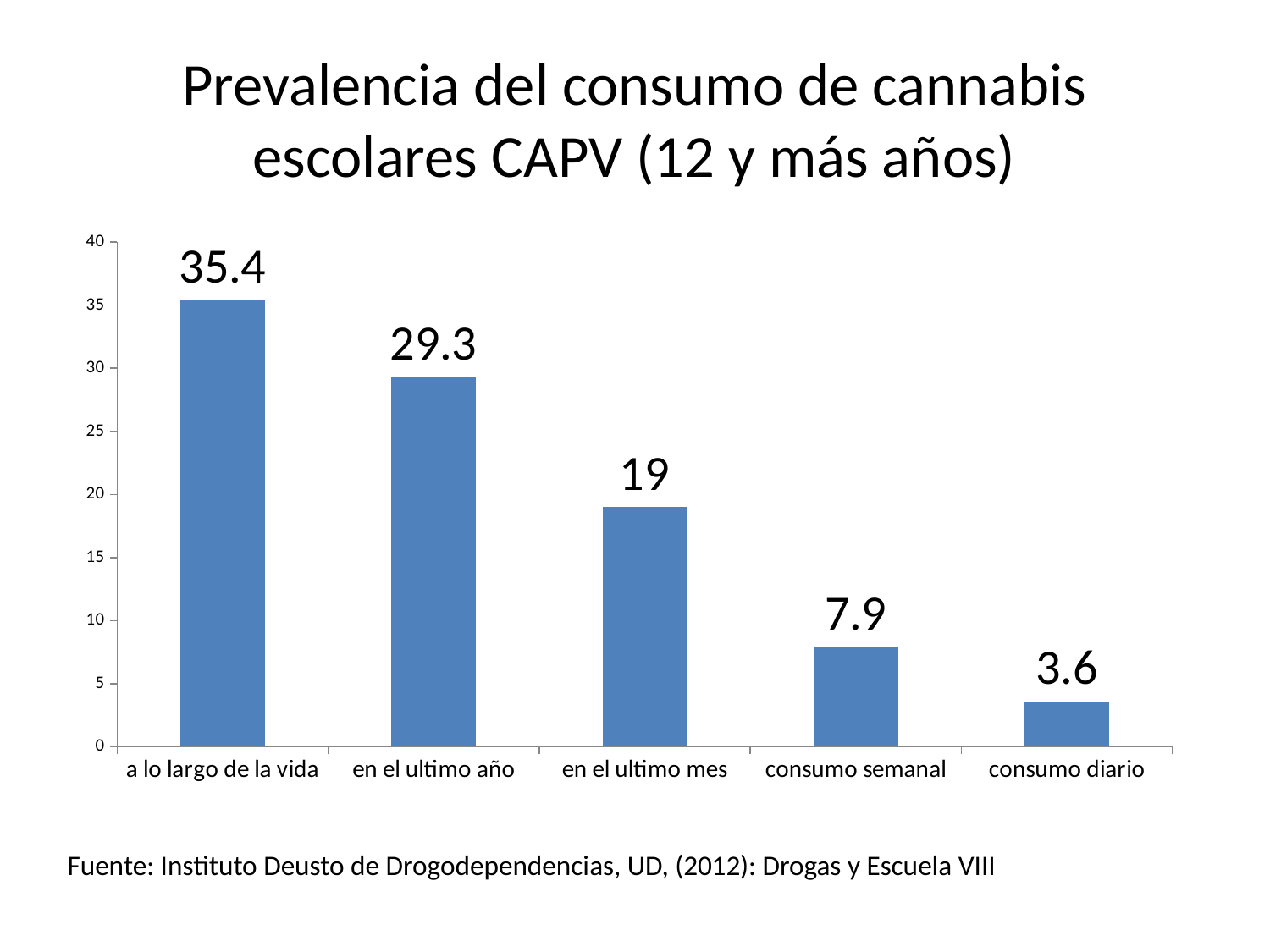
What kind of chart is shown on the slide? bar chart What is the value for 'en el ultimo mes'? 19 What is the value for 'a lo largo de la vida'? 35.4 Which category has the lowest value? consumo diario What is the value for 'consumo semanal'? 7.9 What is the value for 'en el ultimo año'? 29.3 Which is larger, the value for 'consumo semanal' or 'consumo diario'? consumo semanal What is the difference between the values for 'a lo largo de la vida' and 'en el ultimo año'? 6.1 Do the values rise or fall from left to right along the x axis? fall What is the value for 'consumo diario'? 3.6 How many categories are shown on the x axis? 5 Which category has the highest value? a lo largo de la vida